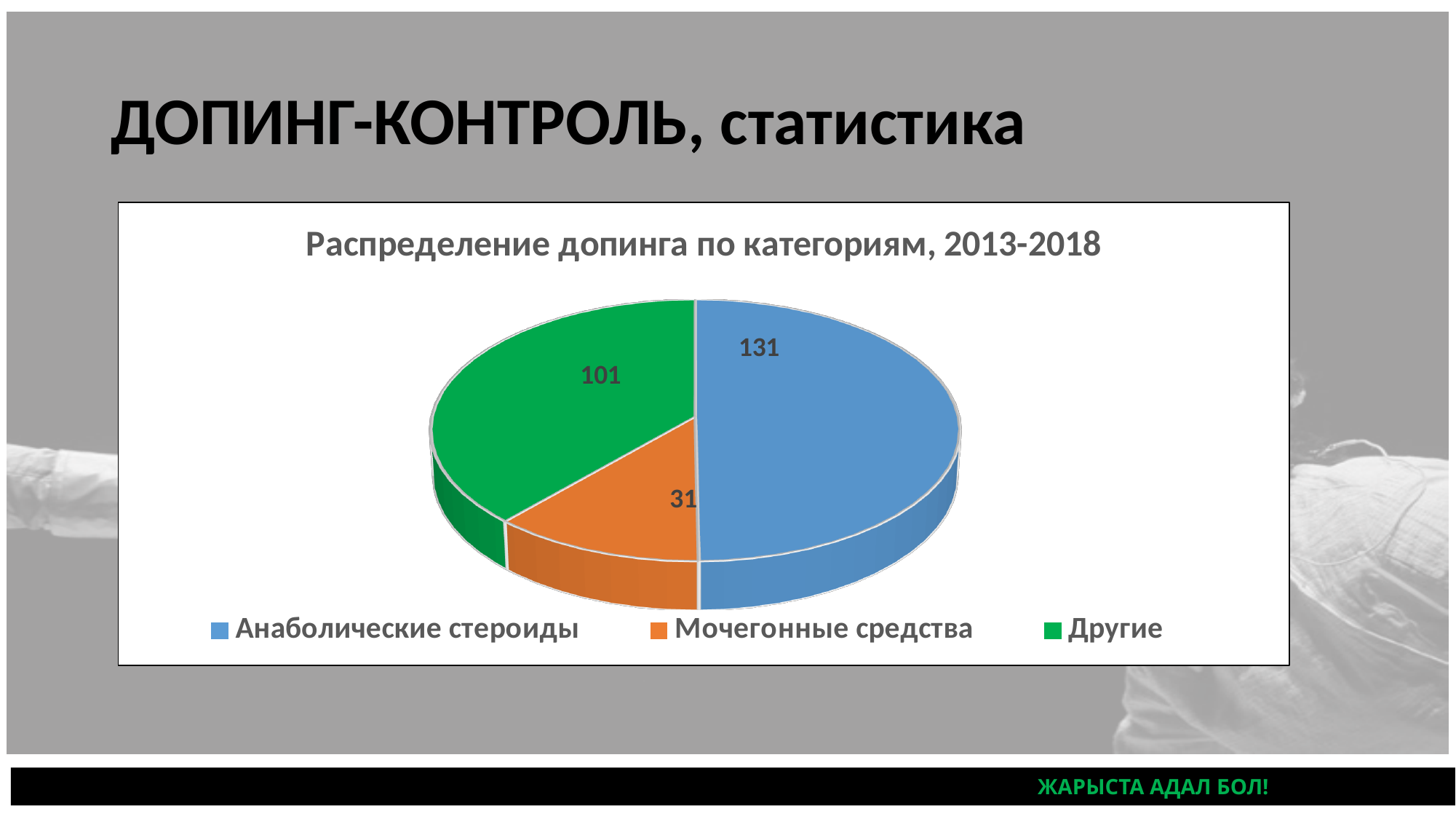
What is the value for Анаболические стероиды? 131 What is the difference between the values for Анаболические стероиды and Другие? 30 What is the value for Другие? 101 Which category has the largest slice of the pie? Анаболические стероиды How many categories does the pie chart show? 3 Which is larger, the value for Другие or the value for Мочегонные средства? Другие What type of chart is shown on the slide? Pie chart What is the title of the chart? Распределение допинга по категориям, 2013-2018 What is the value for Мочегонные средства? 31 What is the difference between the values for Другие and Мочегонные средства? 70 Which category has the smallest slice of the pie? Мочегонные средства What is the total of all the values in the pie chart? 263